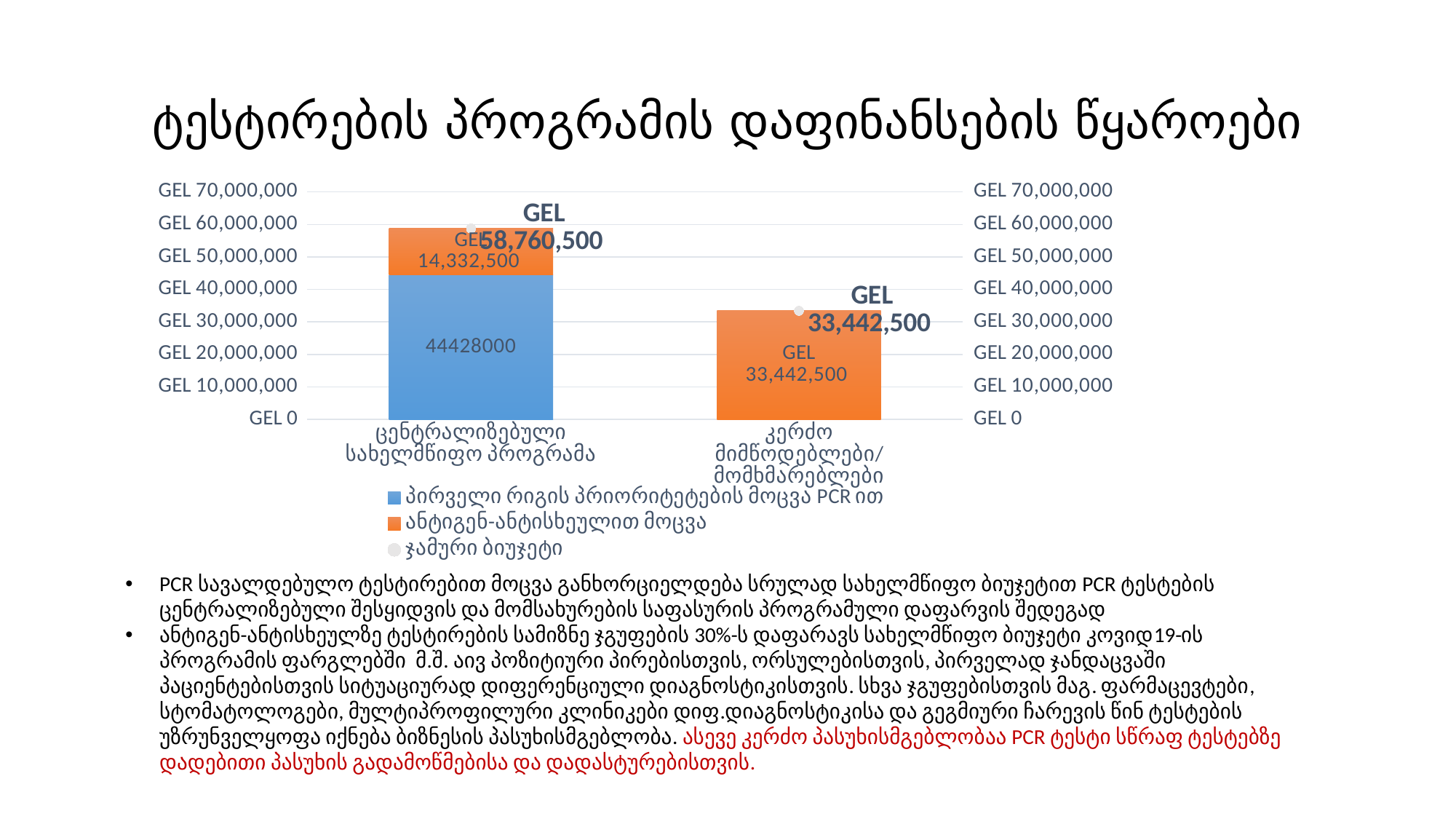
Which category has the higher total budget ('ჯამური ბიუჯეტი')? ცენტრალიზებული სახელმწიფო პროგრამა What type of chart is shown on the slide? stacked bar chart What is the value of the 'ანტიგენ-ანტისხეულით მოცვა' series for 'ცენტრალიზებული სახელმწიფო პროგრამა'? GEL 14,332,500 What is the 'ჯამური ბიუჯეტი' value for 'კერძო მიმწოდებლები/მომხმარებლები'? GEL 33,442,500 Is the total for 'კერძო მიმწოდებლები/მომხმარებლები' greater or less than GEL 40,000,000? less What is the difference between the total budgets of 'ცენტრალიზებული სახელმწიფო პროგრამა' and 'კერძო მიმწოდებლები/მომხმარებლები'? GEL 25,318,000 Which colour represents the 'ანტიგენ-ანტისხეულით მოცვა' series in the chart? orange What is the value of the 'ანტიგენ-ანტისხეულით მოცვა' series for 'კერძო მიმწოდებლები/მომხმარებლები'? GEL 33,442,500 What is the 'ჯამური ბიუჯეტი' value for 'ცენტრალიზებული სახელმწიფო პროგრამა'? GEL 58,760,500 How many series does the chart legend list? 3 What is the value of the 'პირველი რიგის პრიორიტეტების მოცვა PCR ით' series for 'ცენტრალიზებული სახელმწიფო პროგრამა'? 44428000 How many categories are shown on the x axis of the chart? 2